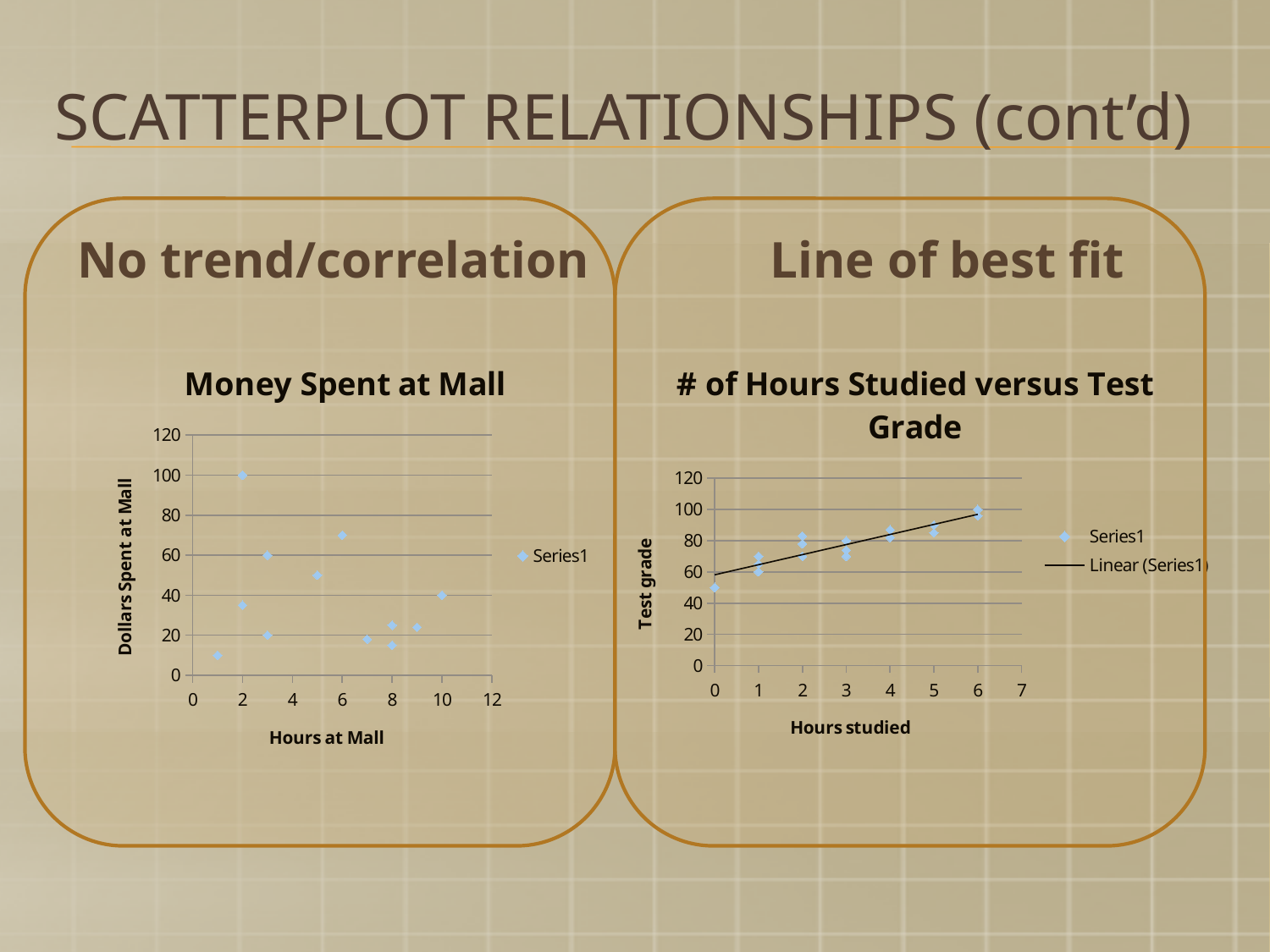
In the 'Money Spent at Mall' chart, what is the title of the x axis? Hours at Mall In the 'Money Spent at Mall' chart, is the highest point greater or less than 80 dollars? greater In the '# of Hours Studied versus Test Grade' chart, at how many hours studied is the highest test grade? 6 In the '# of Hours Studied versus Test Grade' chart, is the test grade at 0 hours studied greater or less than 60? less What kind of chart is the 'Money Spent at Mall' chart? scatter chart In the '# of Hours Studied versus Test Grade' chart, do test grades rise or fall as hours studied increase? rise How many entries does the legend of the '# of Hours Studied versus Test Grade' chart list? 2 In the '# of Hours Studied versus Test Grade' chart, what is the title of the y axis? Test grade In the 'Money Spent at Mall' chart, is the value at 10 hours at the mall greater or less than 60? less In the 'Money Spent at Mall' chart, at how many hours at the mall is the highest amount of dollars spent? 2 What kind of chart is the '# of Hours Studied versus Test Grade' chart? scatter chart How many entries does the legend of the 'Money Spent at Mall' chart list? 1